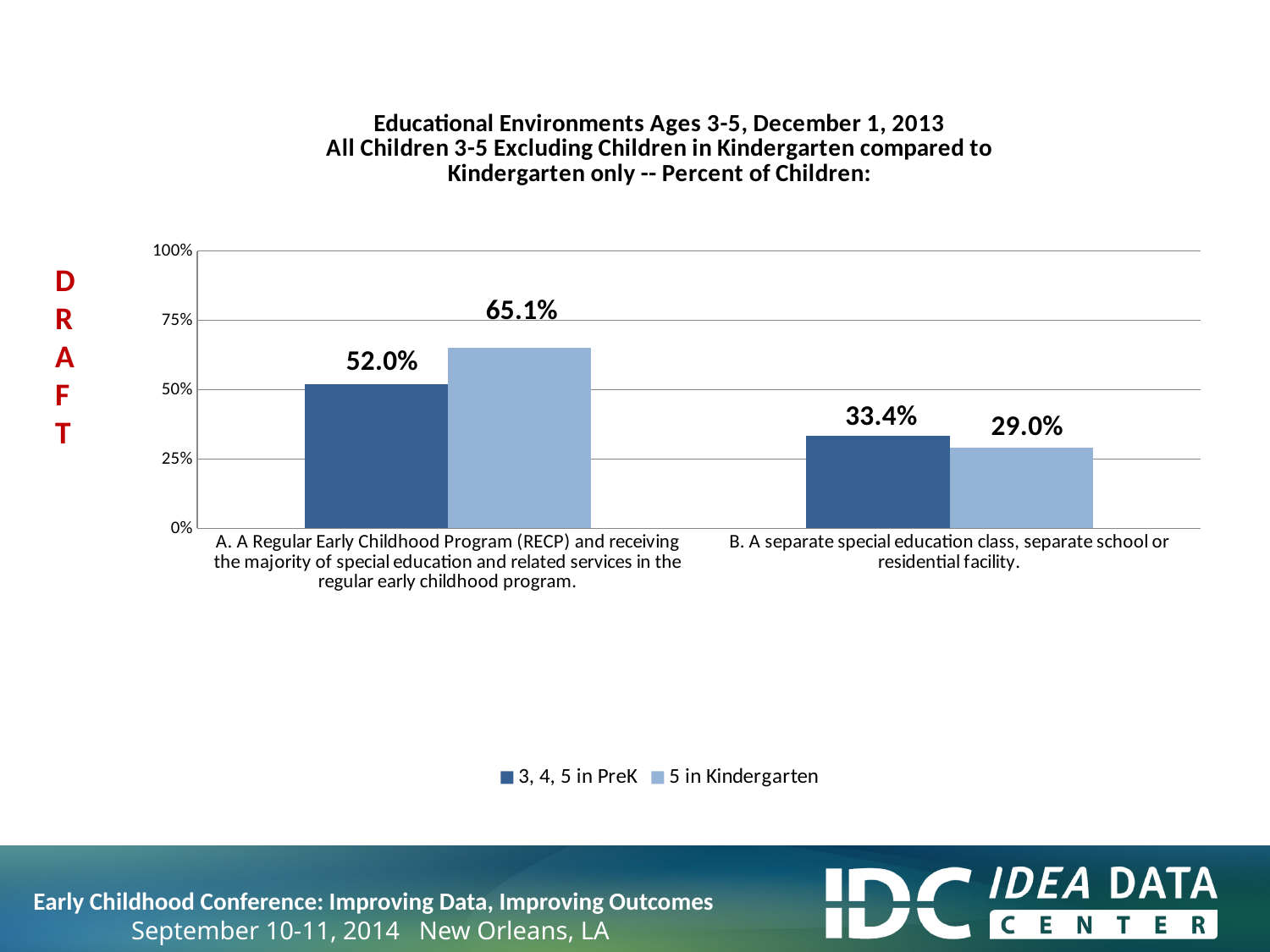
What is the difference between the '3, 4, 5 in PreK' and '5 in Kindergarten' values in category B? 4.4% How many series does the legend list? 2 What is the value for '5 in Kindergarten' in category B (separate special education class, separate school or residential facility)? 29.0% In category B, which series has the larger value: '3, 4, 5 in PreK' or '5 in Kindergarten'? 3, 4, 5 in PreK What is the difference between the '5 in Kindergarten' and '3, 4, 5 in PreK' values in category A? 13.1% What kind of chart is shown on the slide? Bar chart What is the value for '5 in Kindergarten' in category A (Regular Early Childhood Program)? 65.1% Which bar has the lowest value on the chart? 5 in Kindergarten, category B (29.0%) Which bar has the highest value on the chart? 5 in Kindergarten, category A (65.1%) What is the value for '3, 4, 5 in PreK' in category B (separate special education class, separate school or residential facility)? 33.4% What is the value for '3, 4, 5 in PreK' in category A (Regular Early Childhood Program)? 52.0% How many categories are shown on the x axis? 2